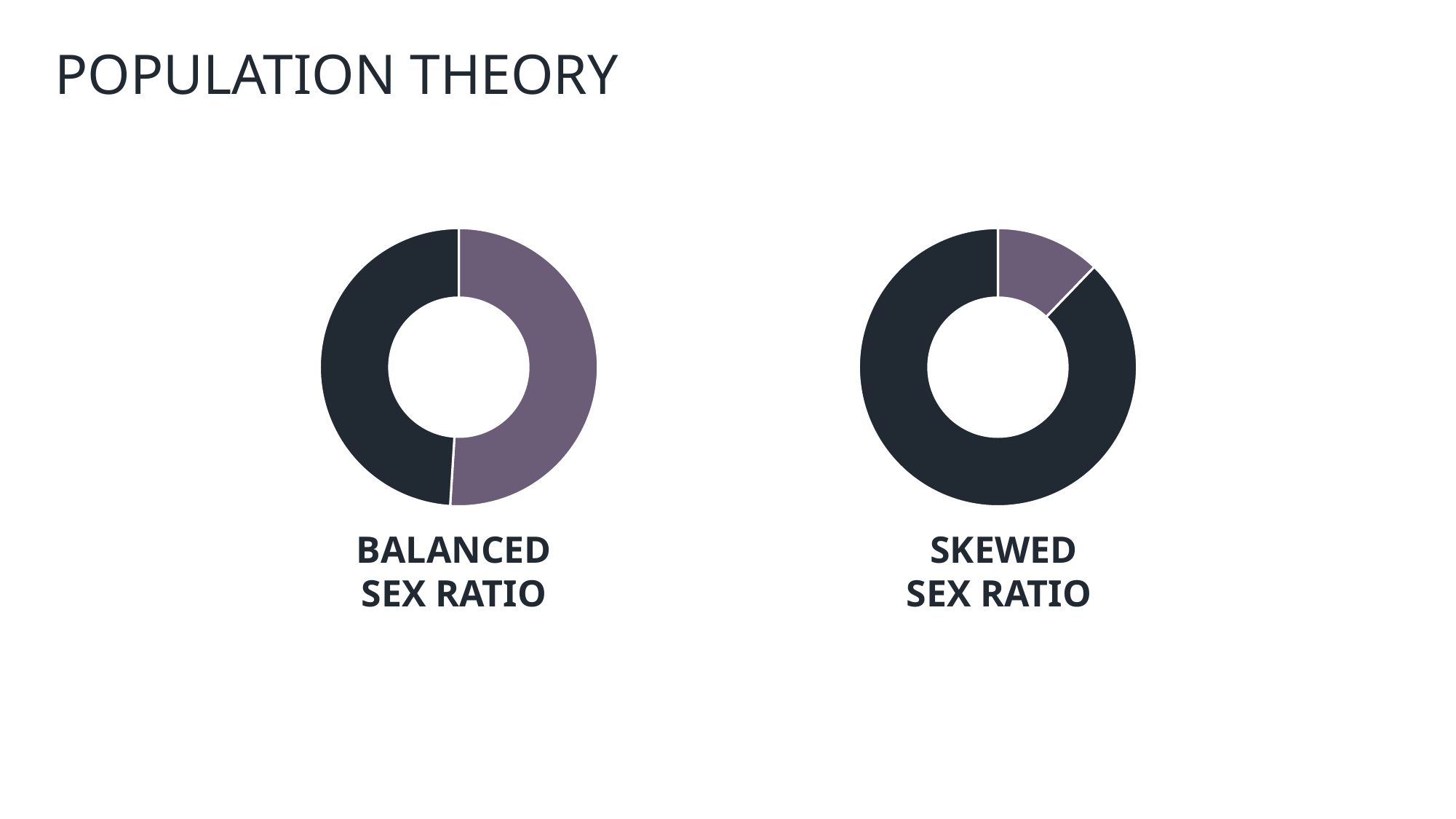
How many charts are shown on the slide? 2 What is the title of the chart on the left of the slide? BALANCED SEX RATIO How many slices does the BALANCED SEX RATIO chart have? 2 What kind of chart is the BALANCED SEX RATIO chart? doughnut chart How many slices does the SKEWED SEX RATIO chart have? 2 What kind of chart is the SKEWED SEX RATIO chart? doughnut chart In the SKEWED SEX RATIO chart, which colour slice is the smallest? purple In the SKEWED SEX RATIO chart, which slice is larger, the dark slice or the purple slice? the dark slice What is the title of the chart on the right of the slide? SKEWED SEX RATIO